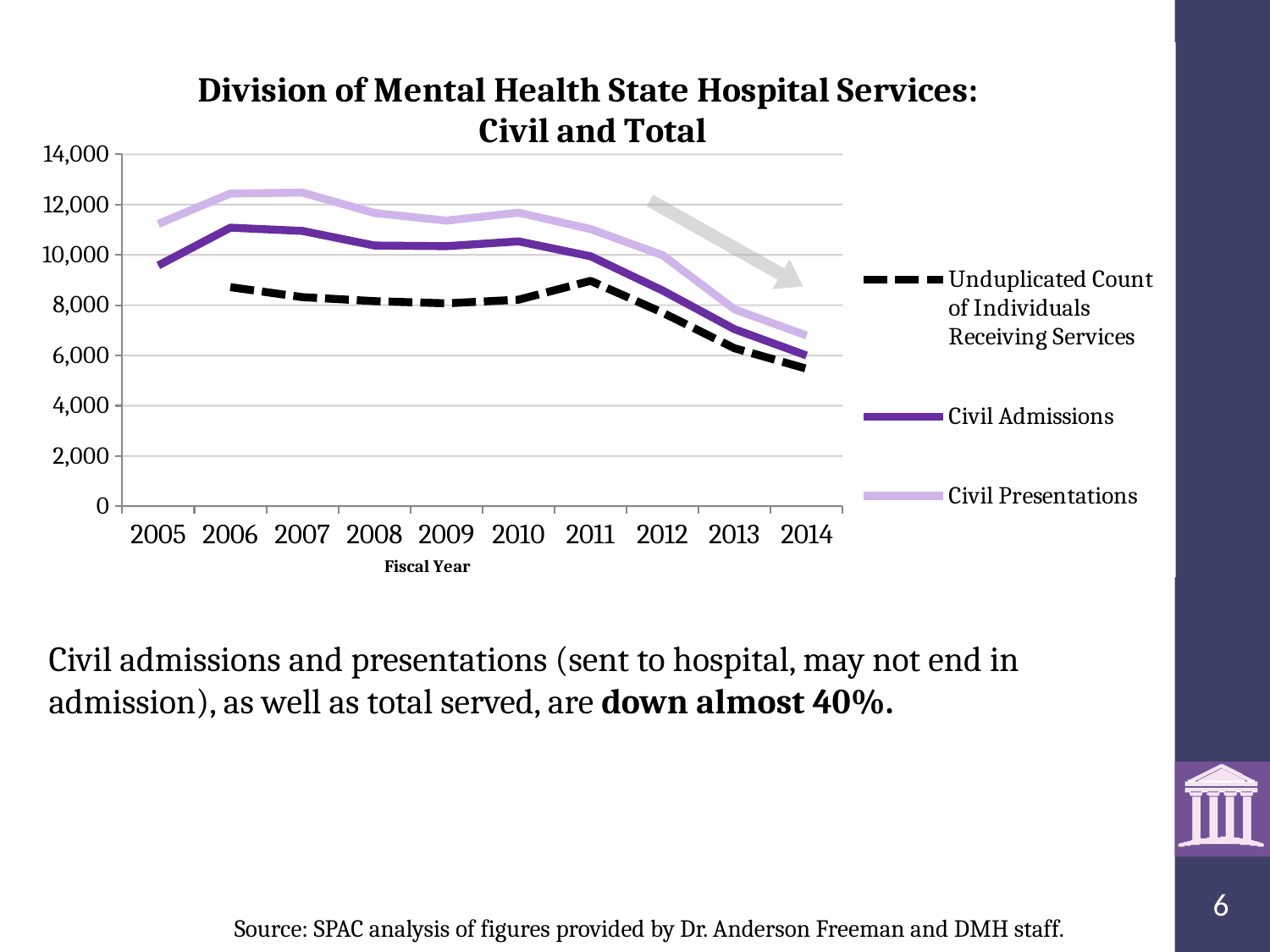
Is the value for Civil Presentations in 2014 greater or less than 6,000? greater Is the value for Civil Admissions in 2005 greater or less than 10,000? less Is the value for Civil Presentations in 2006 greater or less than 12,000? greater What kind of chart is shown on the slide? line chart How many series does the legend list? 3 Do the Civil Admissions values rise or fall from 2011 to 2014? fall What is the title of the chart? Division of Mental Health State Hospital Services: Civil and Total What is the label of the x axis? Fiscal Year How many fiscal years are shown on the x axis? 10 In 2010, which is larger: Civil Presentations or Civil Admissions? Civil Presentations In which fiscal year is the Civil Presentations series at its lowest? 2014